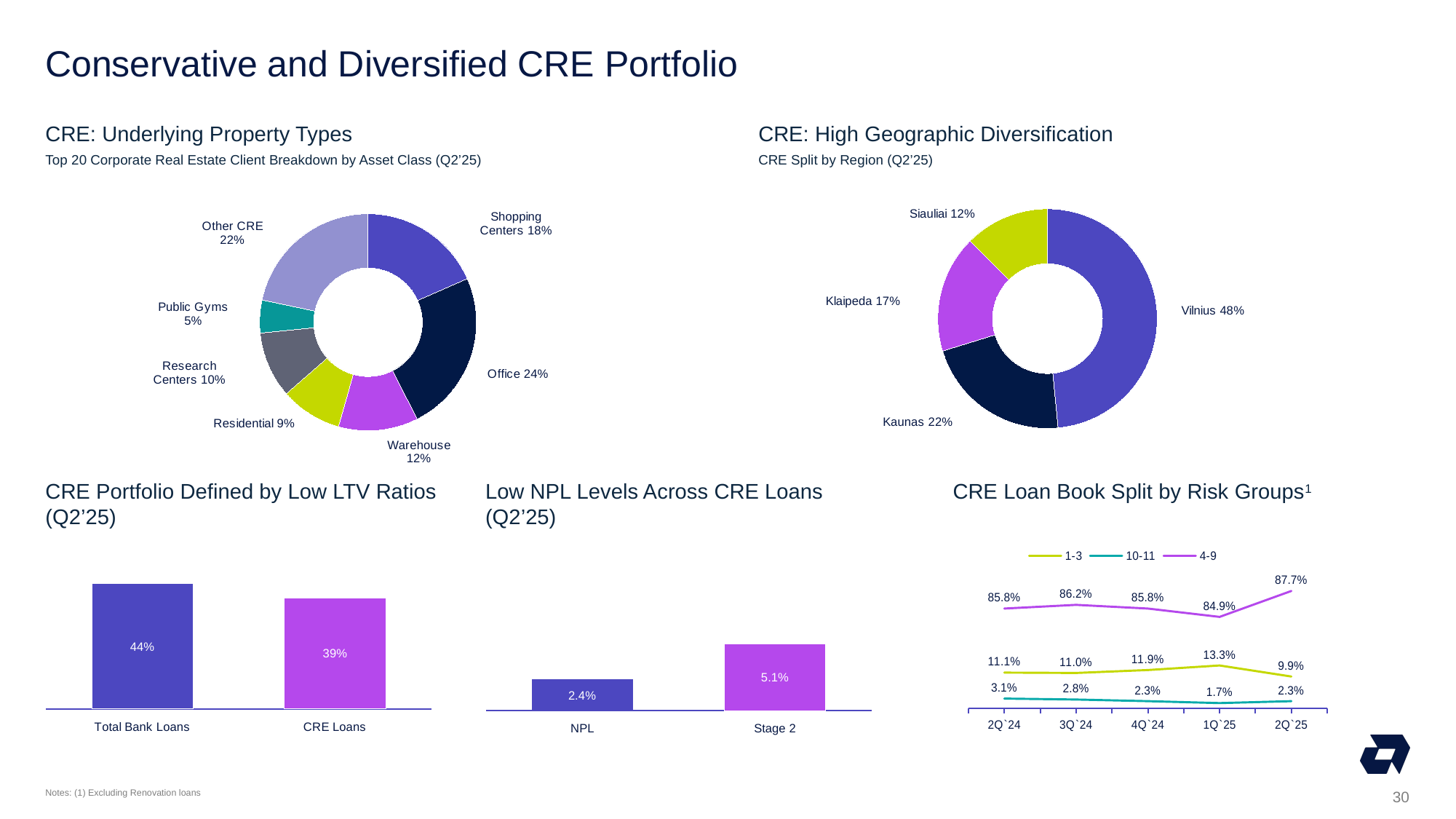
In the 'CRE Portfolio Defined by Low LTV Ratios (Q2'25)' chart, which is larger, Total Bank Loans or CRE Loans? Total Bank Loans In the 'CRE: Underlying Property Types' chart, which property type has the smallest share? Public Gyms In the 'CRE Loan Book Split by Risk Groups' chart, in which quarter does the 1-3 series reach its highest value? 1Q`25 How many series does the legend of the 'CRE Loan Book Split by Risk Groups' chart list? 3 What kind of chart is 'CRE: High Geographic Diversification'? Donut (pie) chart In the 'Low NPL Levels Across CRE Loans (Q2'25)' chart, what is the difference between Stage 2 and NPL? 2.7% In the 'CRE Loan Book Split by Risk Groups' chart, what is the value of the 4-9 series in 2Q`25? 87.7% In the 'CRE: Underlying Property Types' chart, what share is Office? 24% How many property types are shown in the 'CRE: Underlying Property Types' chart? 7 In the 'CRE Portfolio Defined by Low LTV Ratios (Q2'25)' chart, what is the value for CRE Loans? 39% In the 'CRE: High Geographic Diversification' chart, what is the difference between the Kaunas and Siauliai shares? 10% In the 'CRE: High Geographic Diversification' chart, which region has the largest share? Vilnius